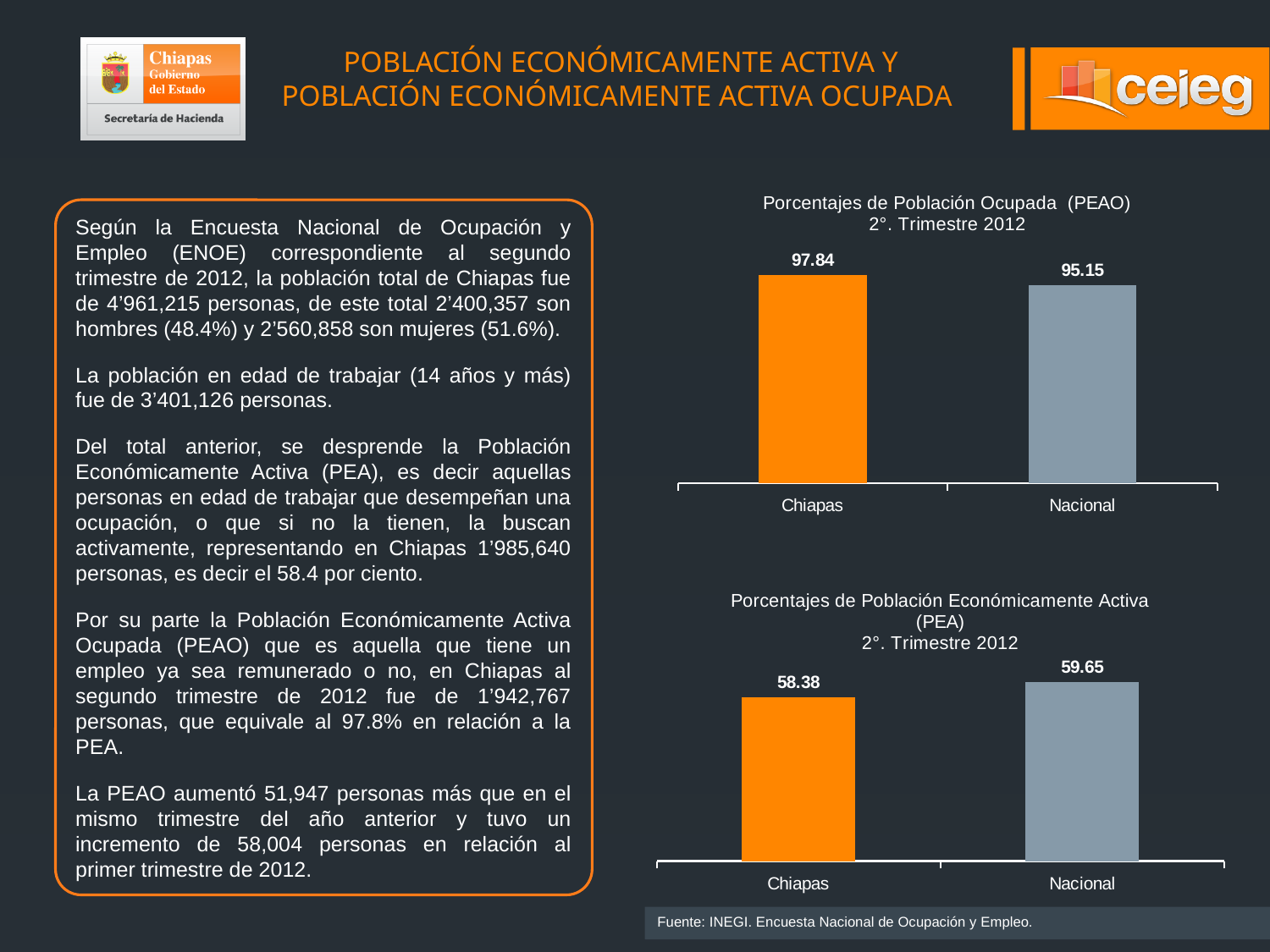
In the top chart (PEAO), which category has the higher value? Chiapas In the top chart (Porcentajes de Población Ocupada (PEAO)), what is the value for Chiapas? 97.84 In the bottom chart (Porcentajes de Población Económicamente Activa (PEA)), what is the value for Chiapas? 58.38 How many categories are shown in the top chart (PEAO)? 2 In the top chart (PEAO), what is the difference between the Chiapas and Nacional values? 2.69 In the bottom chart (PEA), which category has the lower value? Chiapas In the top chart (Porcentajes de Población Ocupada (PEAO)), what is the value for Nacional? 95.15 In the bottom chart (PEA), what is the difference between the Nacional and Chiapas values? 1.27 Which quarter and year do both charts refer to, according to their titles? 2°. Trimestre 2012 What kind of chart is the bottom chart (PEA)? bar chart In the bottom chart (Porcentajes de Población Económicamente Activa (PEA)), what is the value for Nacional? 59.65 In the bottom chart (PEA), is the value for Chiapas larger or smaller than the value for Nacional? smaller